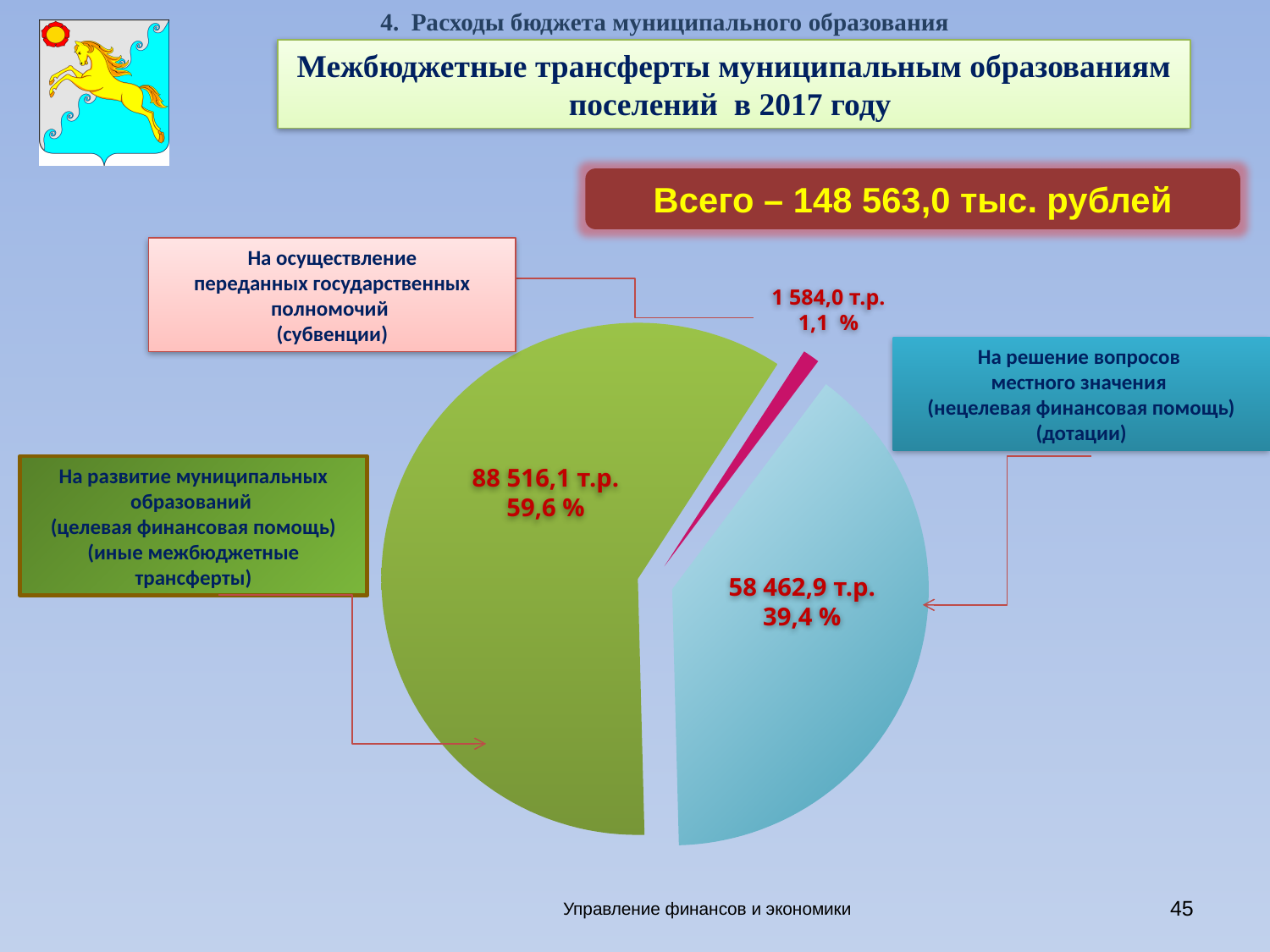
Какая категория имеет наибольшую долю на диаграмме? На развитие муниципальных образований (целевая финансовая помощь) (иные межбюджетные трансферты) Каким цветом на диаграмме показан сектор «На решение вопросов местного значения (дотации)»? Голубым Какая сумма приходится на развитие муниципальных образований (иные межбюджетные трансферты)? 88 516,1 т.р. Какая сумма приходится на осуществление переданных государственных полномочий (субвенции)? 1 584,0 т.р. Что больше: сумма на дотации или сумма на иные межбюджетные трансферты? Иные межбюджетные трансферты Каков общий объём межбюджетных трансфертов, указанный на слайде? 148 563,0 тыс. рублей Сколько секторов (категорий) показано на круговой диаграмме? 3 Какой тип диаграммы представлен на слайде? Круговая диаграмма Какая доля приходится на решение вопросов местного значения (дотации)? 39,4 % Какая доля приходится на осуществление переданных государственных полномочий (субвенции)? 1,1 % Какая категория имеет наименьшую долю на диаграмме? На осуществление переданных государственных полномочий (субвенции) На сколько сумма на иные межбюджетные трансферты превышает сумму на дотации? 30 053,2 т.р.